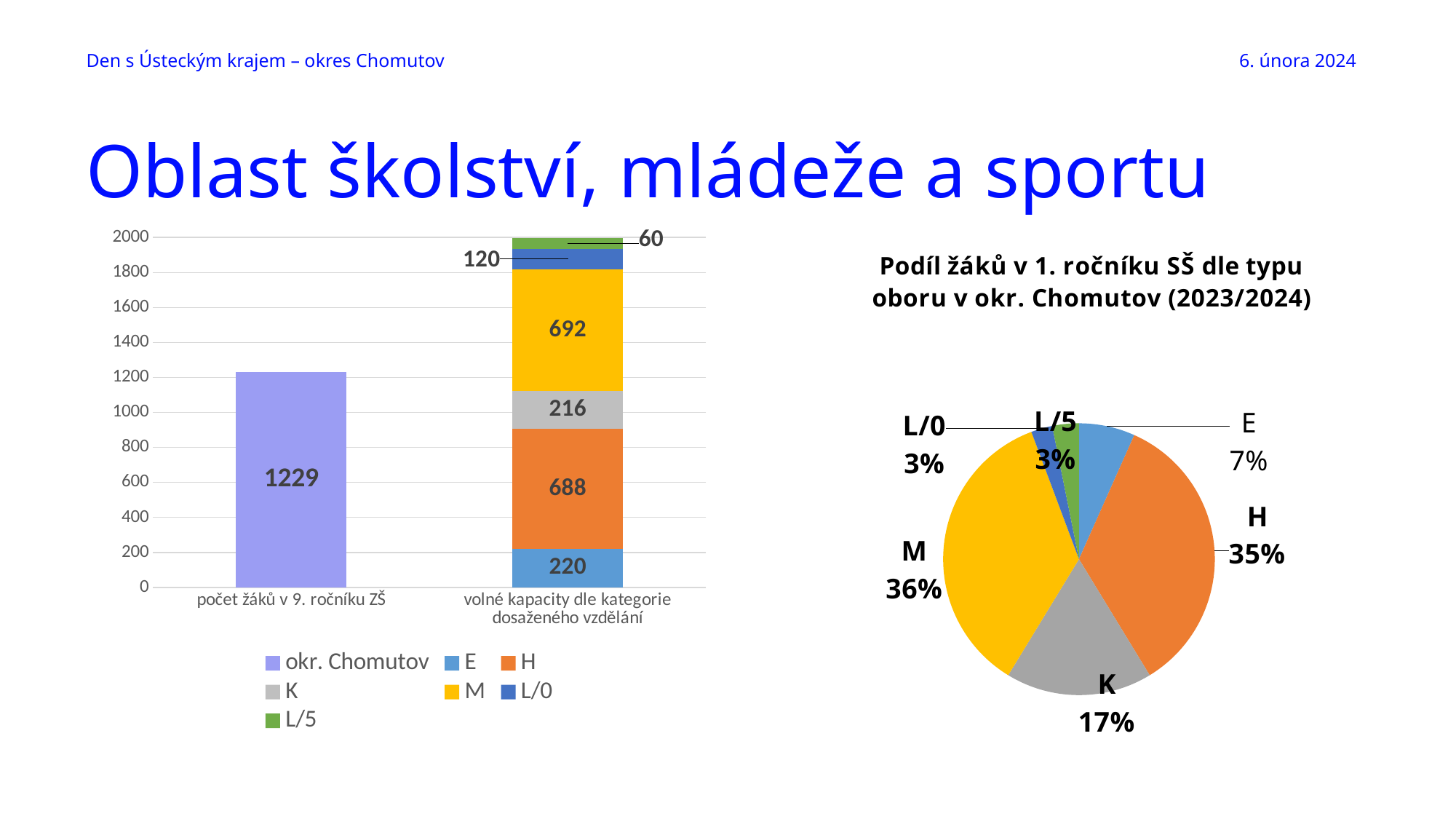
In the left bar chart, how many series does the legend list? 7 In the left bar chart, what is the value for 'počet žáků v 9. ročníku ZŠ'? 1229 In the pie chart 'Podíl žáků v 1. ročníku SŠ dle typu oboru v okr. Chomutov (2023/2024)', what share does K have? 17% In the pie chart 'Podíl žáků v 1. ročníku SŠ dle typu oboru v okr. Chomutov (2023/2024)', which slice is the largest? M In the left bar chart, which is larger in the stacked bar: the E segment or the K segment? E In the left bar chart, what is the value of the M segment in the 'volné kapacity dle kategorie dosaženého vzdělání' bar? 692 In the left bar chart, what is the total of the stacked 'volné kapacity dle kategorie dosaženého vzdělání' bar? 1996 What kind of chart is the chart on the left of the slide? bar chart In the pie chart 'Podíl žáků v 1. ročníku SŠ dle typu oboru v okr. Chomutov (2023/2024)', what share does H have? 35% In the pie chart 'Podíl žáků v 1. ročníku SŠ dle typu oboru v okr. Chomutov (2023/2024)', how many slices are there? 6 In the left bar chart, what is the difference between the M segment and the H segment of the stacked bar? 4 In the left bar chart, what is the value of the H segment in the 'volné kapacity dle kategorie dosaženého vzdělání' bar? 688